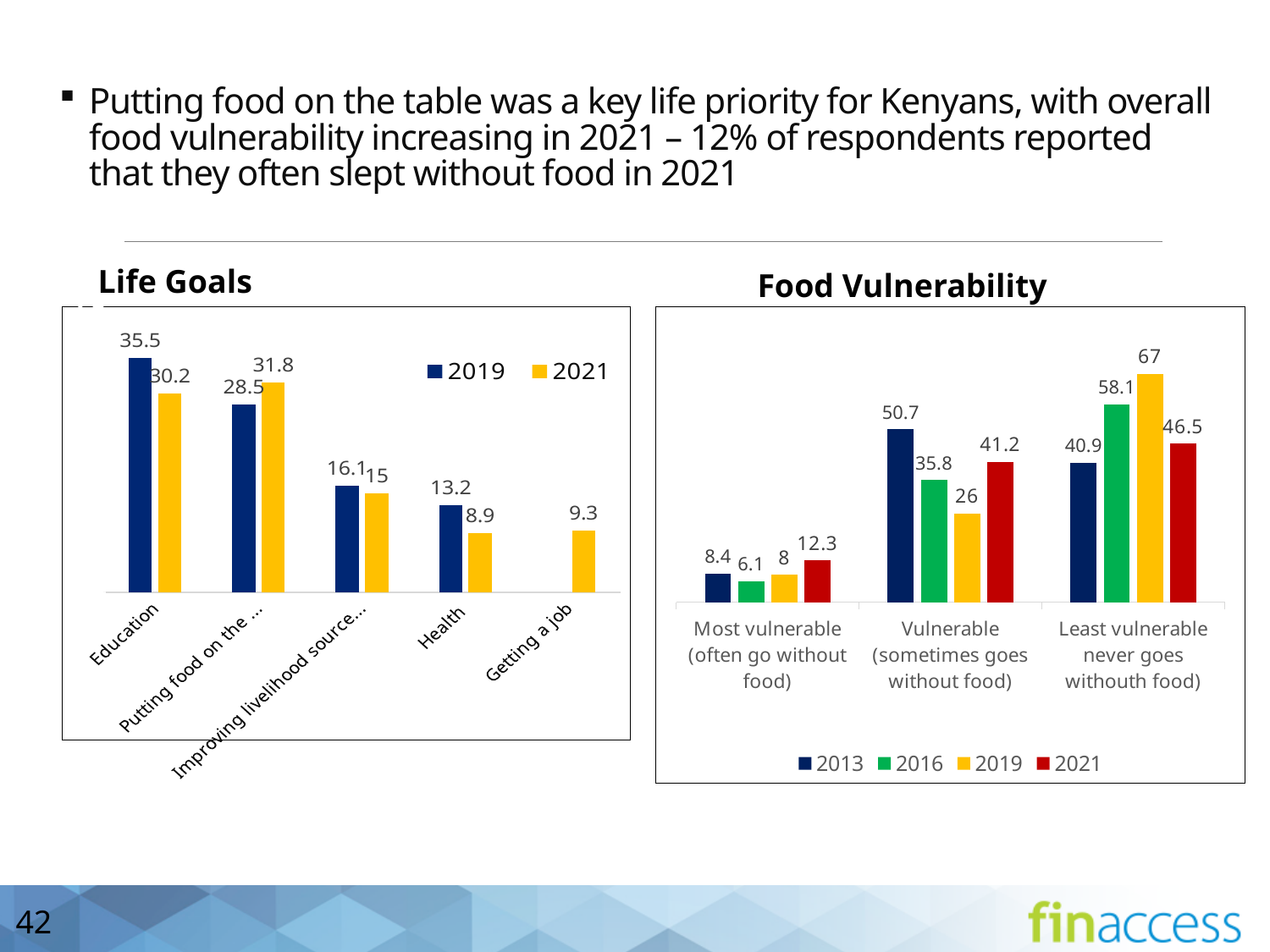
In the Food Vulnerability chart, which year has the lowest value for Vulnerable (sometimes goes without food)? 2019 What type of chart is the Food Vulnerability chart? Bar chart In the Life Goals chart, what is the 2019 value for Education? 35.5 In the Food Vulnerability chart, how many series does the legend list? 4 In the Life Goals chart, what is the 2021 value for Health? 8.9 In the Food Vulnerability chart, what is the 2019 value for Least vulnerable never goes withouth food? 67 In the Life Goals chart, how many series does the legend list? 2 In the Life Goals chart, what is the difference between the 2019 and 2021 values for Education? 5.3 In the Life Goals chart, which category has the highest 2019 value? Education In the Life Goals chart, what is the 2021 value for Getting a job? 9.3 In the Food Vulnerability chart, what is the 2021 value for Most vulnerable (often go without food)? 12.3 In the Food Vulnerability chart, is the 2013 value for Vulnerable larger or the 2021 value? 2013